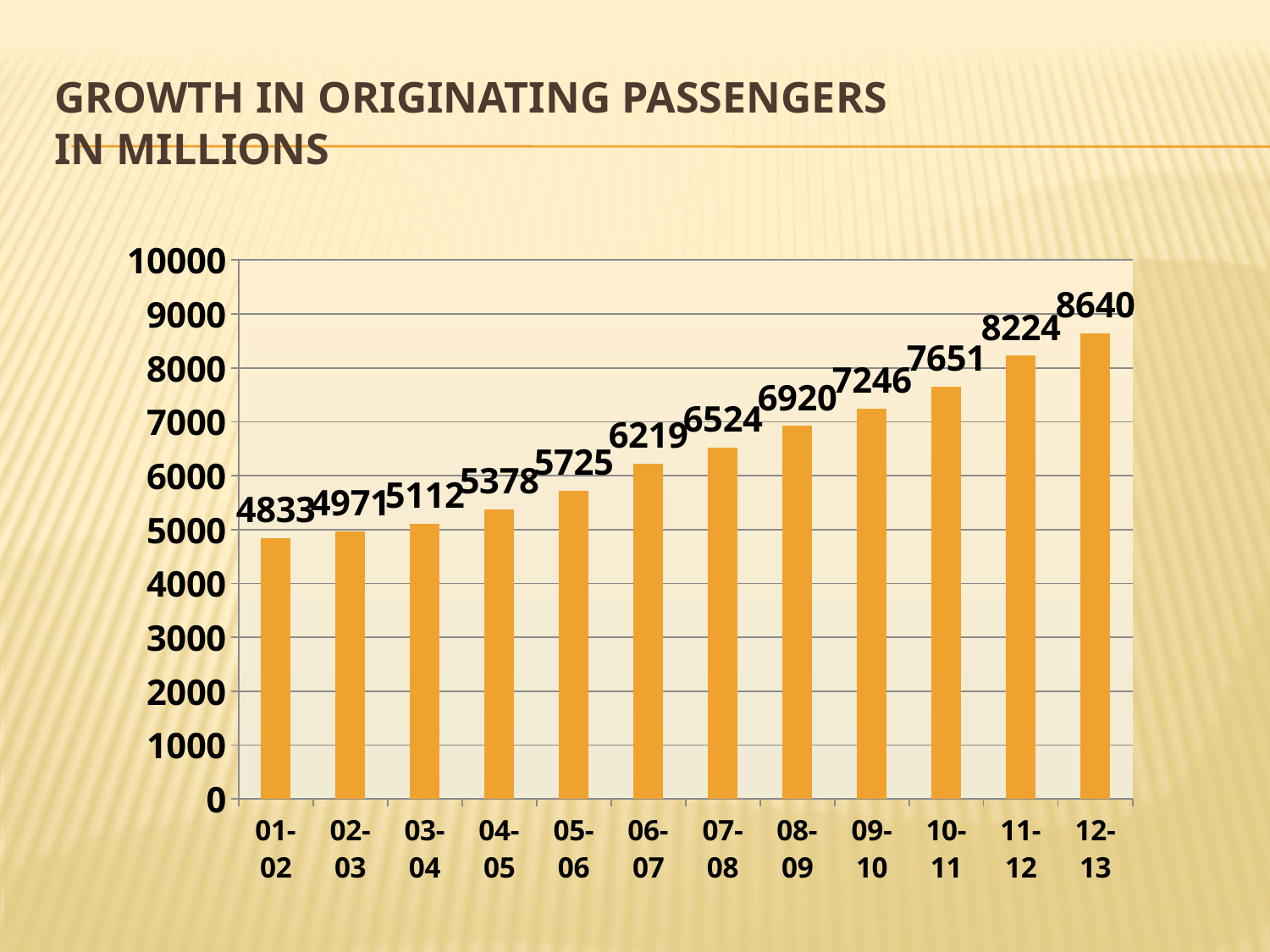
Which is larger, the value for 05-06 or the value for 08-09? 08-09 What is the value for 07-08? 6524 Is the value for 06-07 greater or less than 6000? greater What kind of chart is shown? bar chart What is the value for 12-13? 8640 What is the difference between the values for 10-11 and 09-10? 405 What is the difference between the values for 12-13 and 01-02? 3807 Do the values rise or fall from 01-02 to 12-13? rise Which year has the highest value? 12-13 Which year has the lowest value? 01-02 What is the value for 01-02? 4833 How many years are shown on the x axis? 12